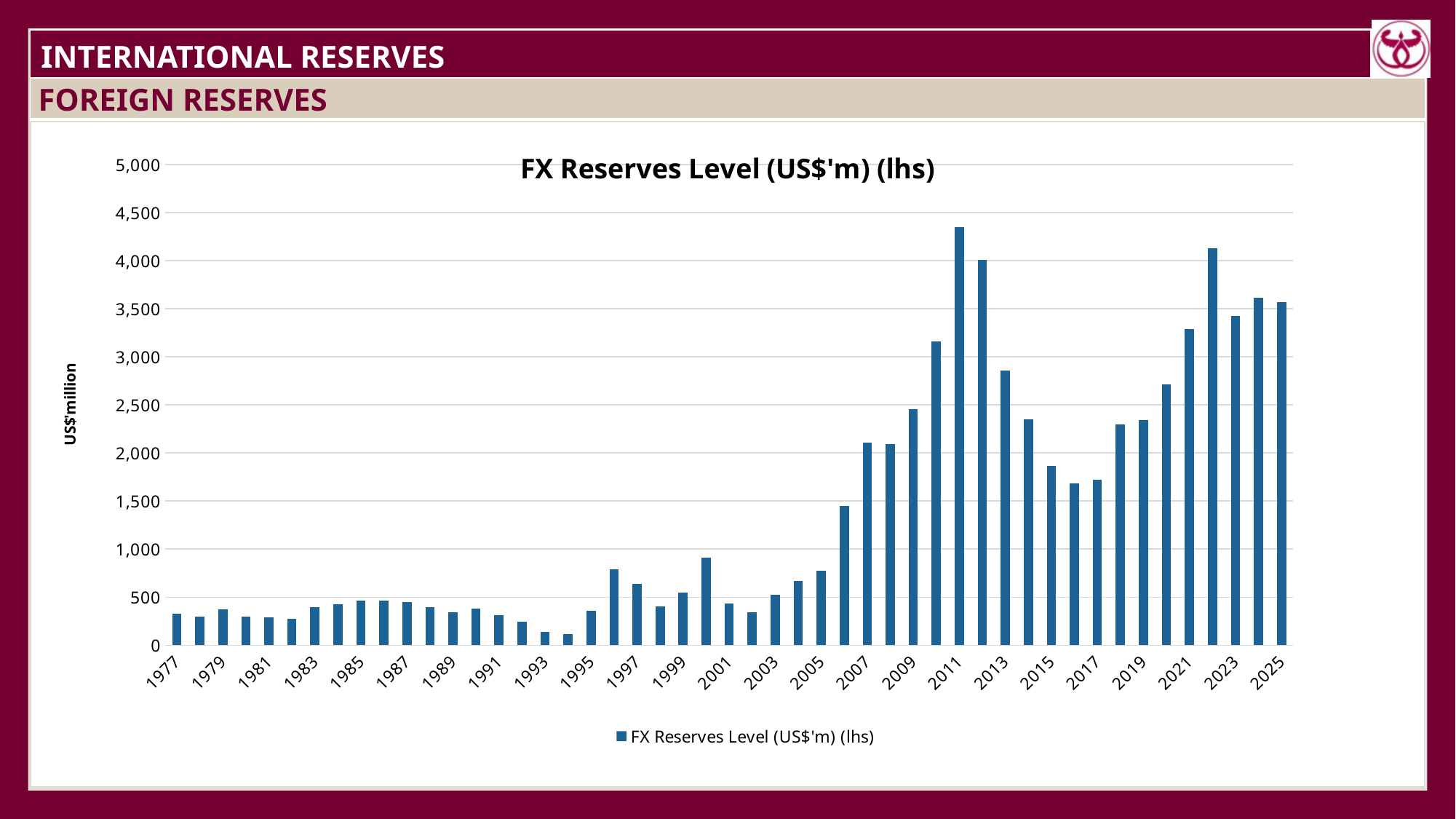
Which year has the higher FX reserves level, 2011 or 2022? 2011 Is the FX reserves level for 2016 greater or less than 2,000? less What kind of chart is shown on the slide? bar chart Is the FX reserves level for 2011 greater or less than 4,000? greater Which year has the highest FX reserves level? 2011 Which year has the higher FX reserves level, 2010 or 2014? 2010 What is the title of the chart? FX Reserves Level (US$'m) (lhs) Is the FX reserves level for 2006 greater or less than 1,000? greater Do FX reserves generally rise or fall from 2011 to 2016? fall How many yearly bars are plotted in the chart? 49 How many series does the legend list? 1